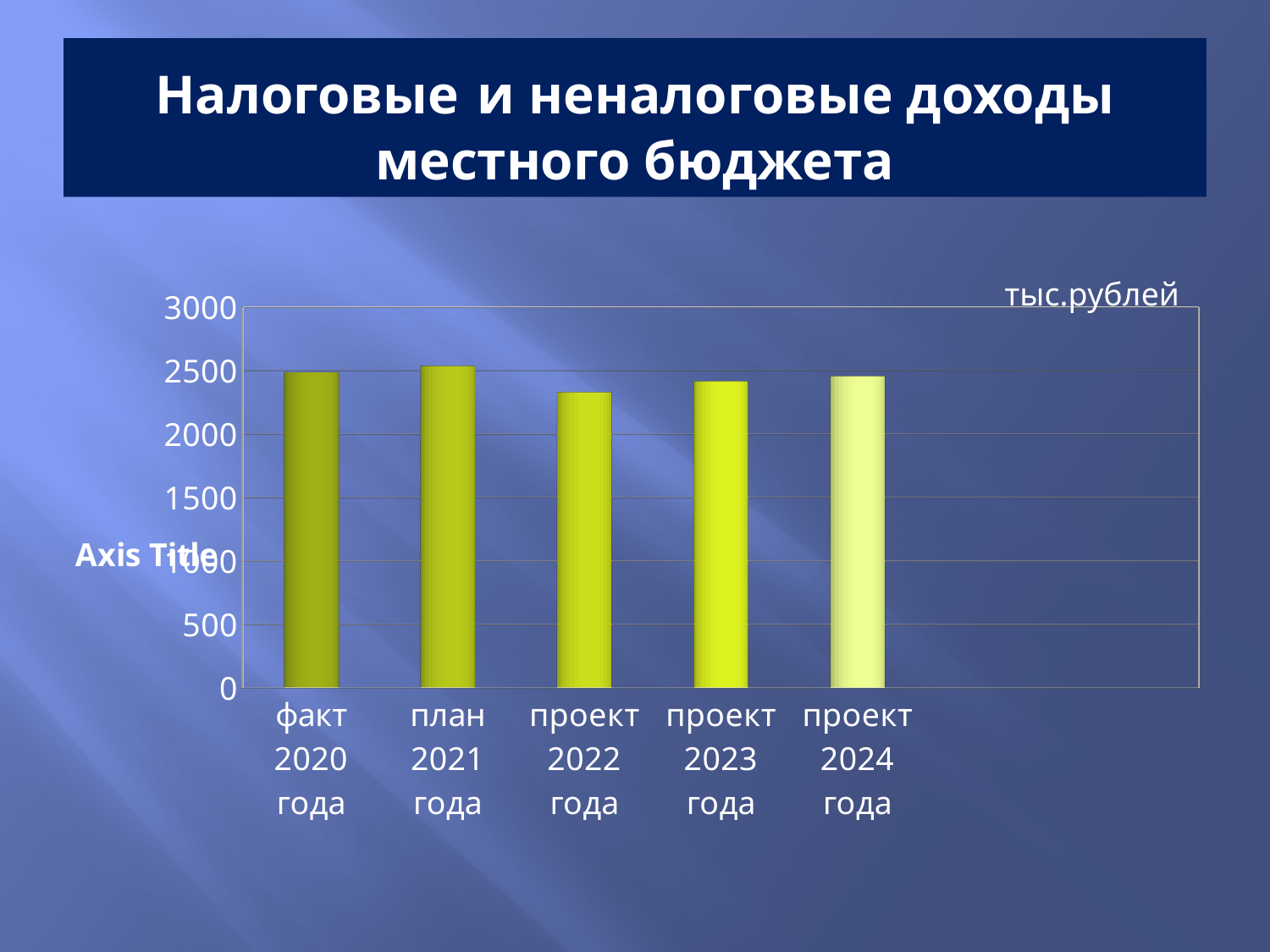
Is the value for проект 2023 года greater or less than 2000? greater What is the title of the slide? Налоговые и неналоговые доходы местного бюджета What unit is indicated in the top right corner of the chart? тыс.рублей What kind of chart is shown on the slide? bar chart How many categories are shown on the x axis of the chart? 5 Is the value for проект 2023 года greater or less than 2500? less Is the value for факт 2020 года greater or less than 2000? greater Which is larger, the value for факт 2020 года or the value for проект 2022 года? факт 2020 года Which category has the lowest bar in the chart? проект 2022 года Which is larger, the value for проект 2022 года or the value for проект 2023 года? проект 2023 года Does the value rise or fall from план 2021 года to проект 2022 года? fall